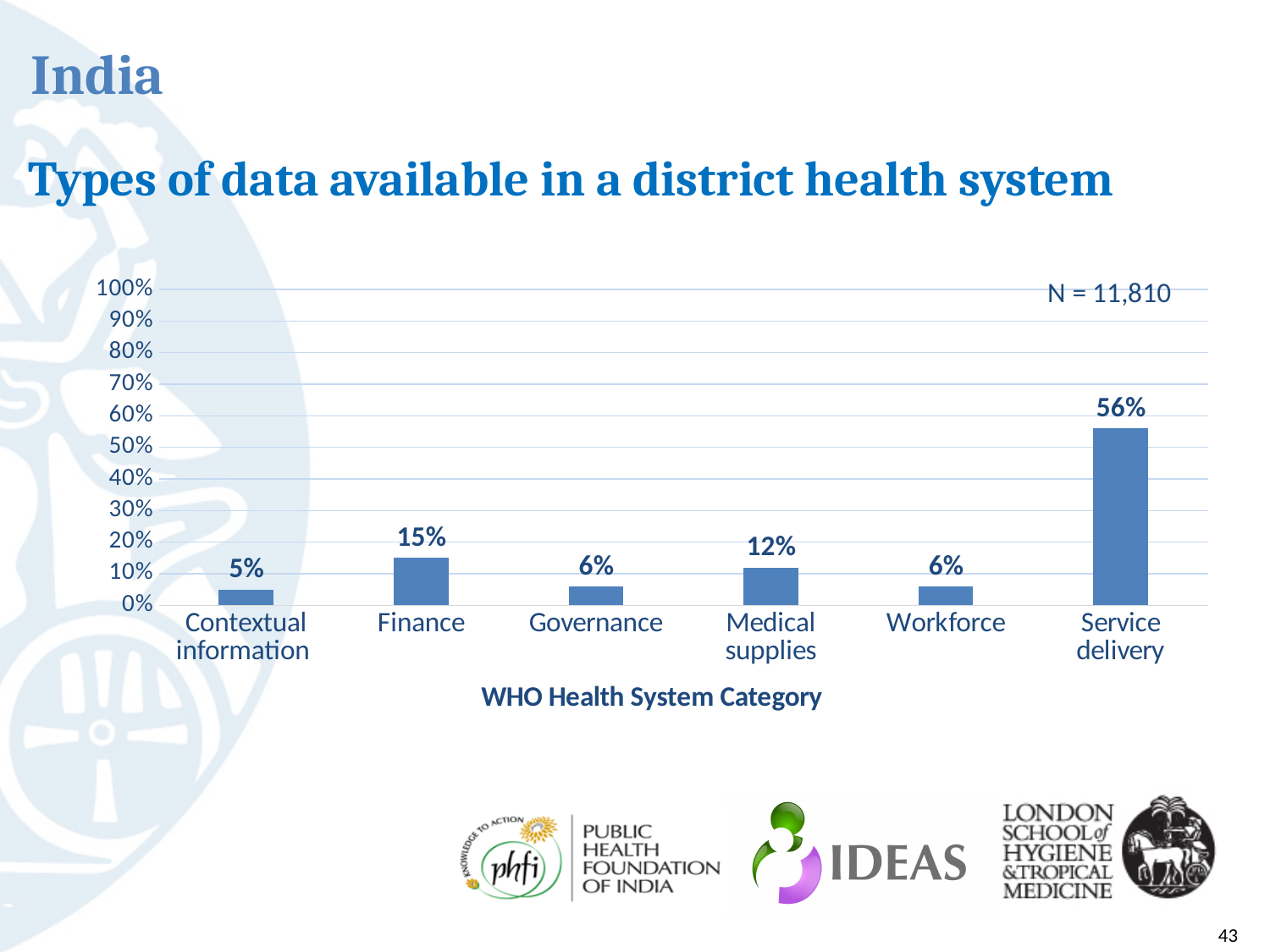
How many categories are shown on the x axis? 6 What kind of chart is shown on the slide? Bar chart What is the value for Service delivery? 56% What is the value for Contextual information? 5% What is the difference between the values for Service delivery and Finance? 41% What is the value for Finance? 15% Which category has the lowest value? Contextual information Which category has the highest value? Service delivery Which is larger, the value for Finance or the value for Medical supplies? Finance What is the value for Medical supplies? 12% Is the value for Service delivery greater or less than 50%? greater What is the x-axis title of the chart? WHO Health System Category